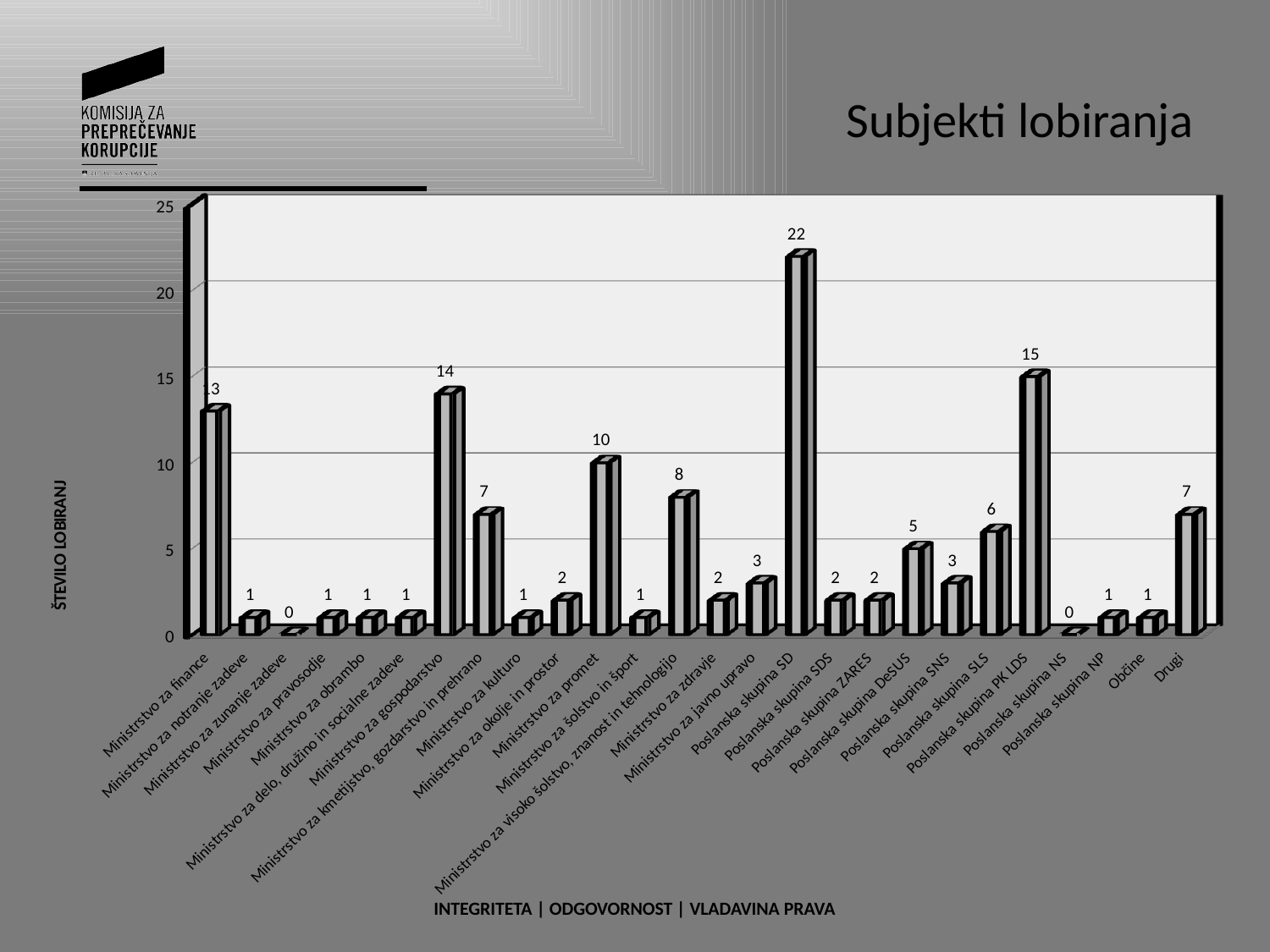
Is the value for Ministrstvo za visoko šolstvo, znanost in tehnologijo greater or less than 5? greater What is the value for Ministrstvo za promet? 10 What is the value for Poslanska skupina PK LDS? 15 How many categories are shown on the x axis? 26 What is the difference between the values for Poslanska skupina SD and Poslanska skupina PK LDS? 7 Which category has the highest value? Poslanska skupina SD Which is larger, the value for Ministrstvo za finance or the value for Ministrstvo za gospodarstvo? Ministrstvo za gospodarstvo What is the label of the vertical axis? ŠTEVILO LOBIRANJ What is the title of the slide? Subjekti lobiranja What is the value for Poslanska skupina SD? 22 What kind of chart is shown on the slide? bar chart What is the value for Ministrstvo za gospodarstvo? 14